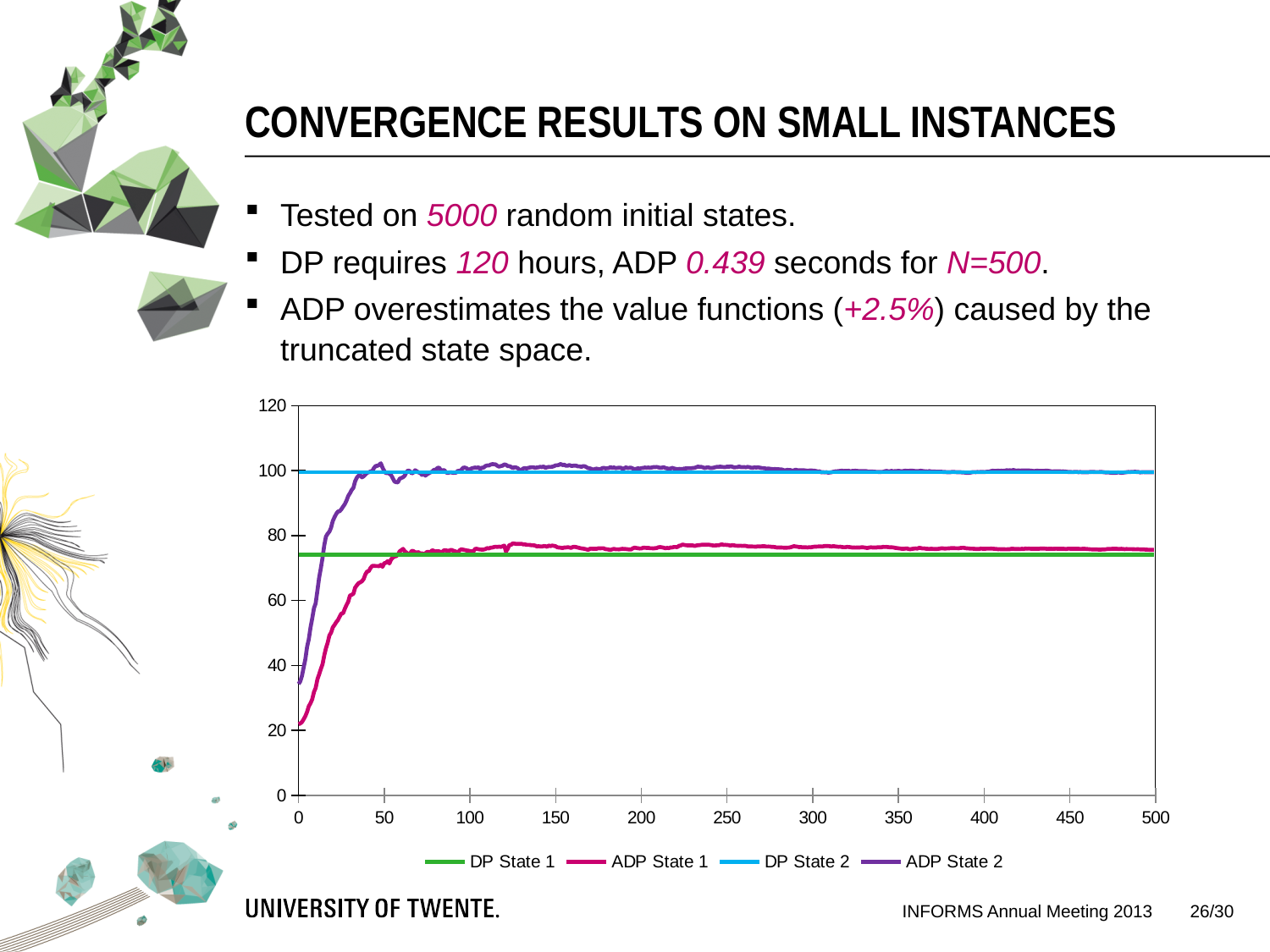
Is the value of DP State 1 greater or less than 80? less Is the value of ADP State 1 at x = 0 greater or less than 40? less What colour is the line for ADP State 2? purple Is the value of DP State 2 greater or less than 80? greater Which series has the lower value at x = 0, ADP State 1 or ADP State 2? ADP State 1 Does the ADP State 1 line rise or fall between x = 0 and x = 100? rise What kind of chart is shown on the slide? line chart Which series are listed in the chart legend? DP State 1, ADP State 1, DP State 2, ADP State 2 Which series has the higher value at x = 500, DP State 2 or DP State 1? DP State 2 How many series does the legend list? 4